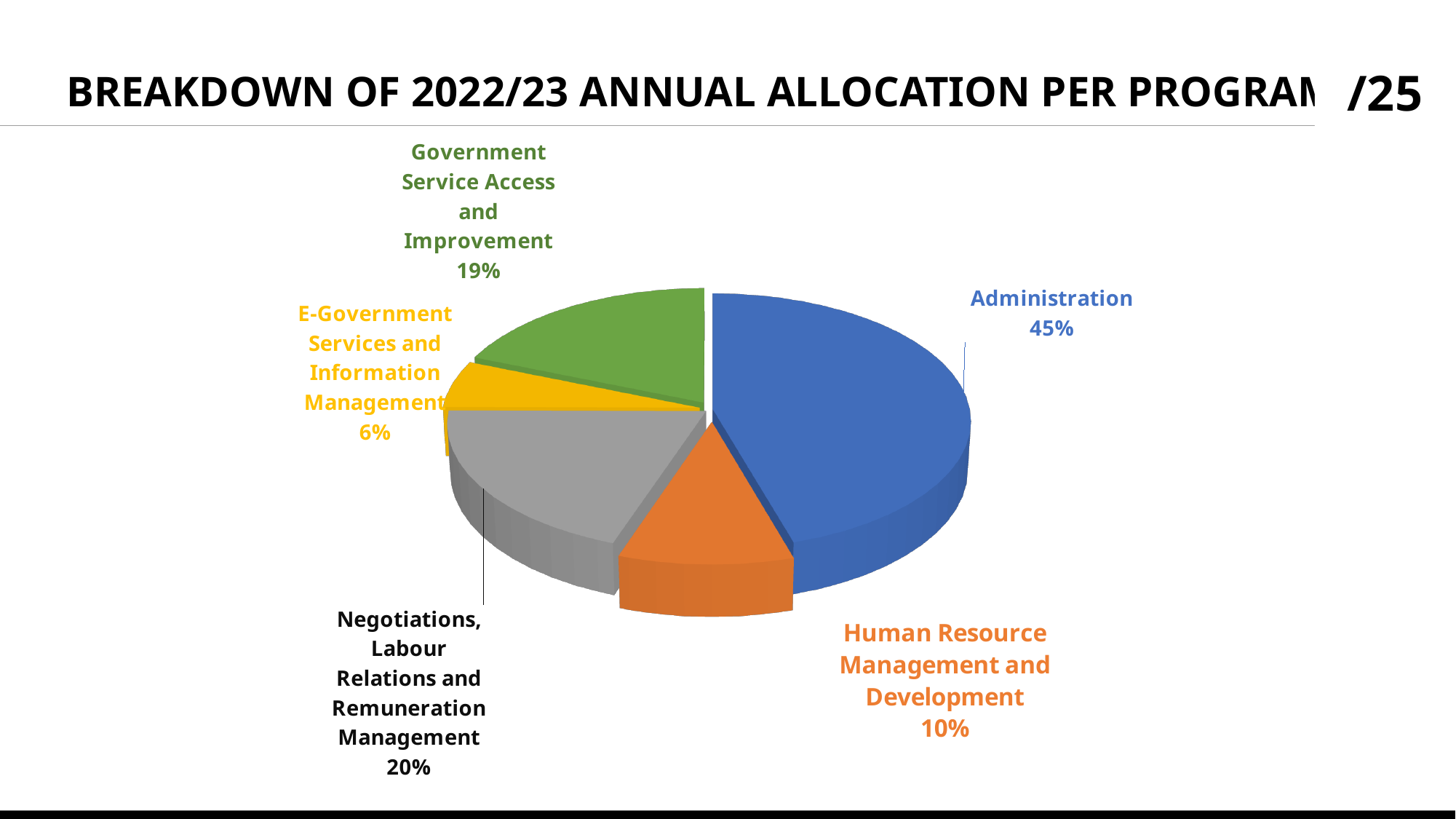
What type of chart is shown on the slide? Pie chart What share of the 2022/23 annual allocation goes to Administration? 45% Which programme receives the smallest share of the allocation? E-Government Services and Information Management What percentage of the allocation is for Human Resource Management and Development? 10% Which programme receives the largest share of the allocation? Administration How many programmes are shown in the pie chart? 5 Which has a larger share: Government Service Access and Improvement or Human Resource Management and Development? Government Service Access and Improvement What share does Negotiations, Labour Relations and Remuneration Management receive? 20% What colour is the Administration slice? Blue What percentage is allocated to E-Government Services and Information Management? 6% How many percentage points larger is the Administration share than the Negotiations, Labour Relations and Remuneration Management share? 25 percentage points What share goes to Government Service Access and Improvement? 19%